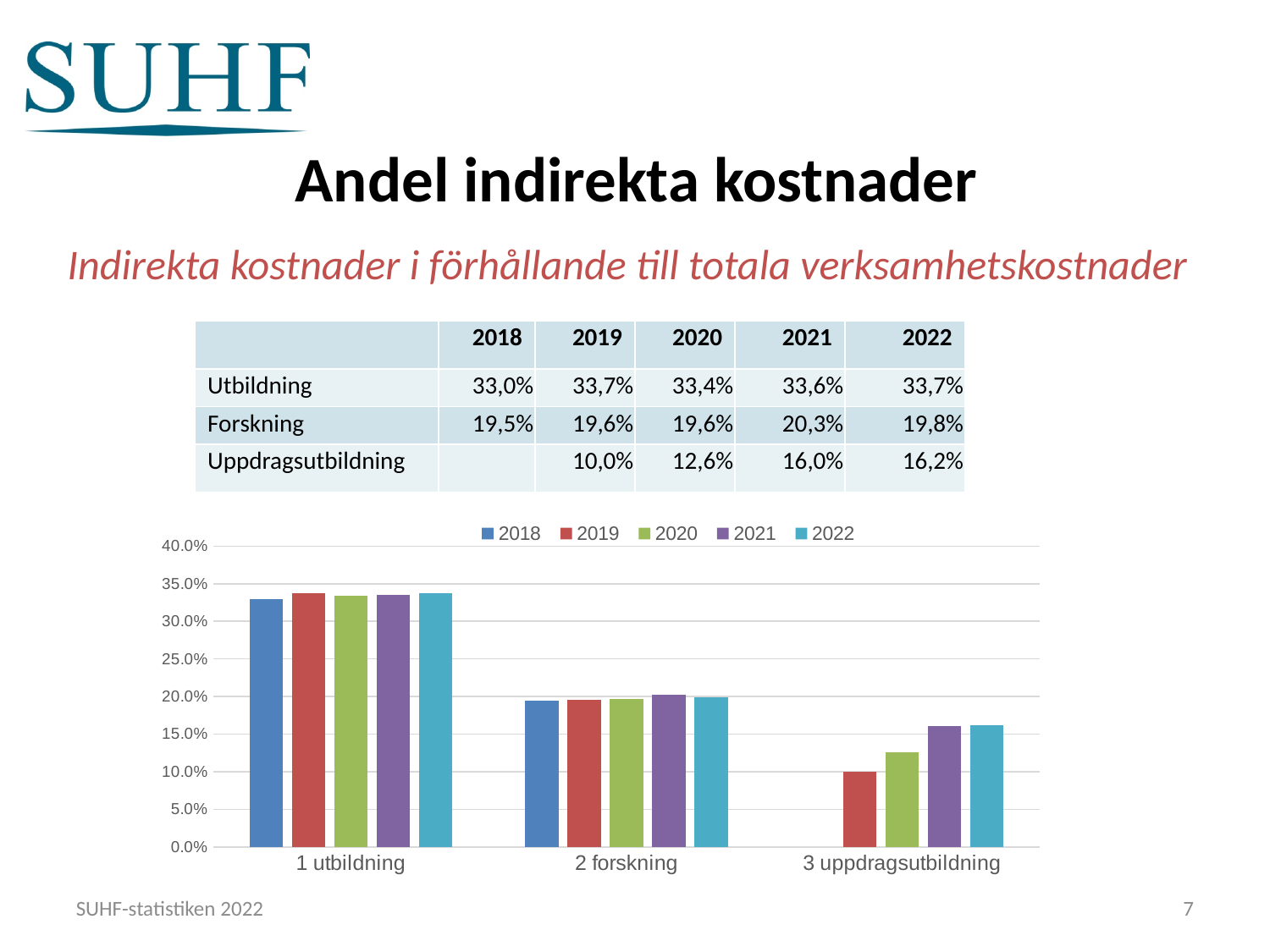
How many series does the chart legend list? 5 Which series is missing a bar for 3 uppdragsutbildning? 2018 Do the values for 3 uppdragsutbildning rise or fall from 2019 to 2022? rise How many categories are shown on the x axis of the chart? 3 What is the difference between the 2022 value for 1 utbildning and the 2022 value for 2 forskning? 13,9% What is the value for 3 uppdragsutbildning in 2019? 10,0% Which category has the lowest value in the chart? 3 uppdragsutbildning What is the value for 1 utbildning in 2018? 33,0% What is the value for 2 forskning in 2021? 20,3% Which category has the highest values in the chart? 1 utbildning What kind of chart is shown on the slide? bar chart Is the value for 2 forskning in 2021 greater or less than 20.0%? greater